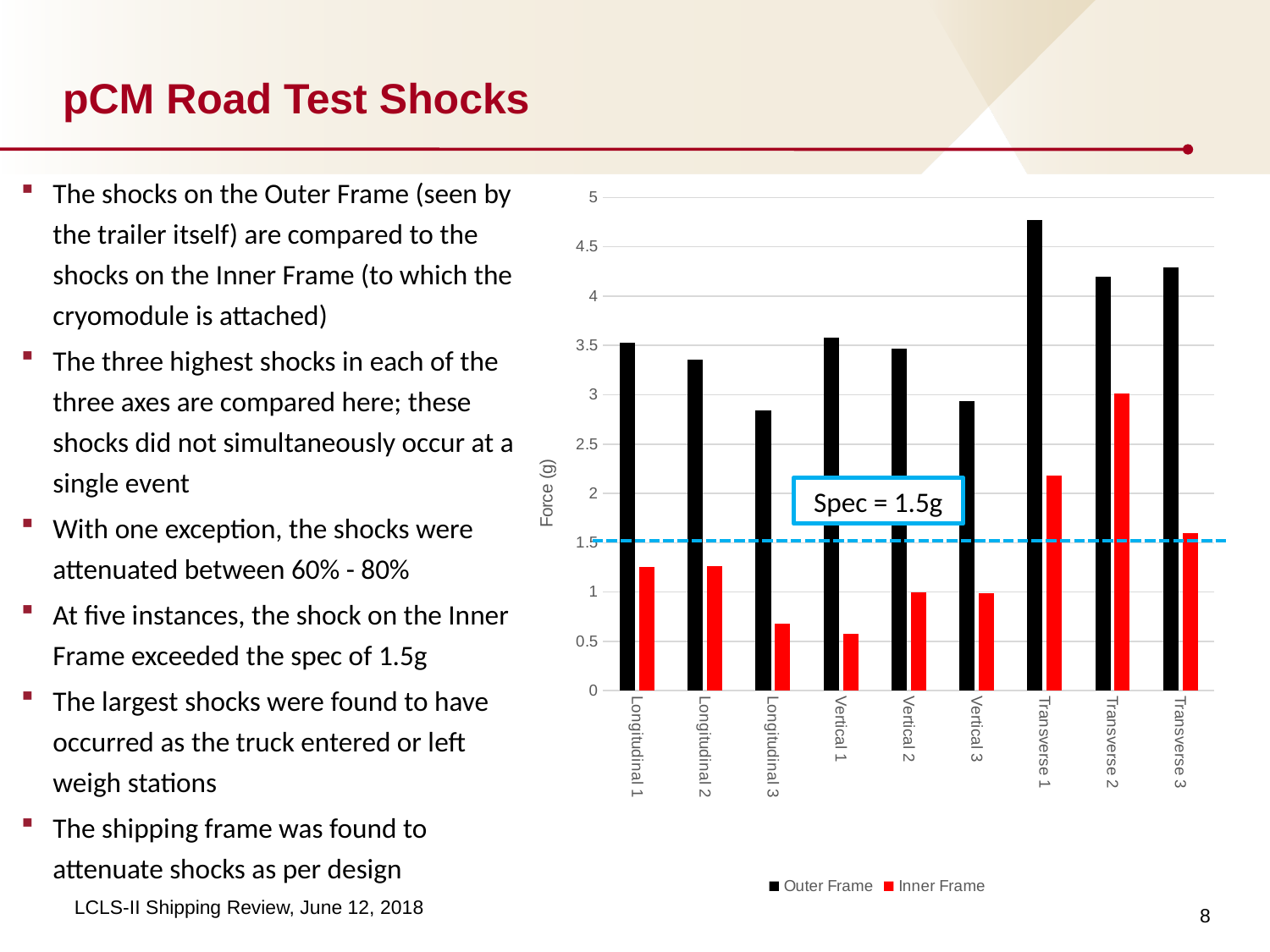
How many series does the chart legend list? 2 What value does the dashed horizontal line on the chart mark, according to its label? Spec = 1.5g How many categories are shown along the x axis of the chart? 9 Which category has the highest Outer Frame value? Transverse 1 Is the Outer Frame value for Transverse 1 greater or less than 4.5? greater What is the label of the chart's y axis? Force (g) Is the Inner Frame value for Transverse 2 greater or less than 2.5? greater Is the Outer Frame value for Longitudinal 3 greater or less than 3? less Which is larger, the Inner Frame value for Transverse 2 or for Transverse 1? Transverse 2 Which category has the highest Inner Frame value? Transverse 2 What kind of chart is shown on the slide? bar chart